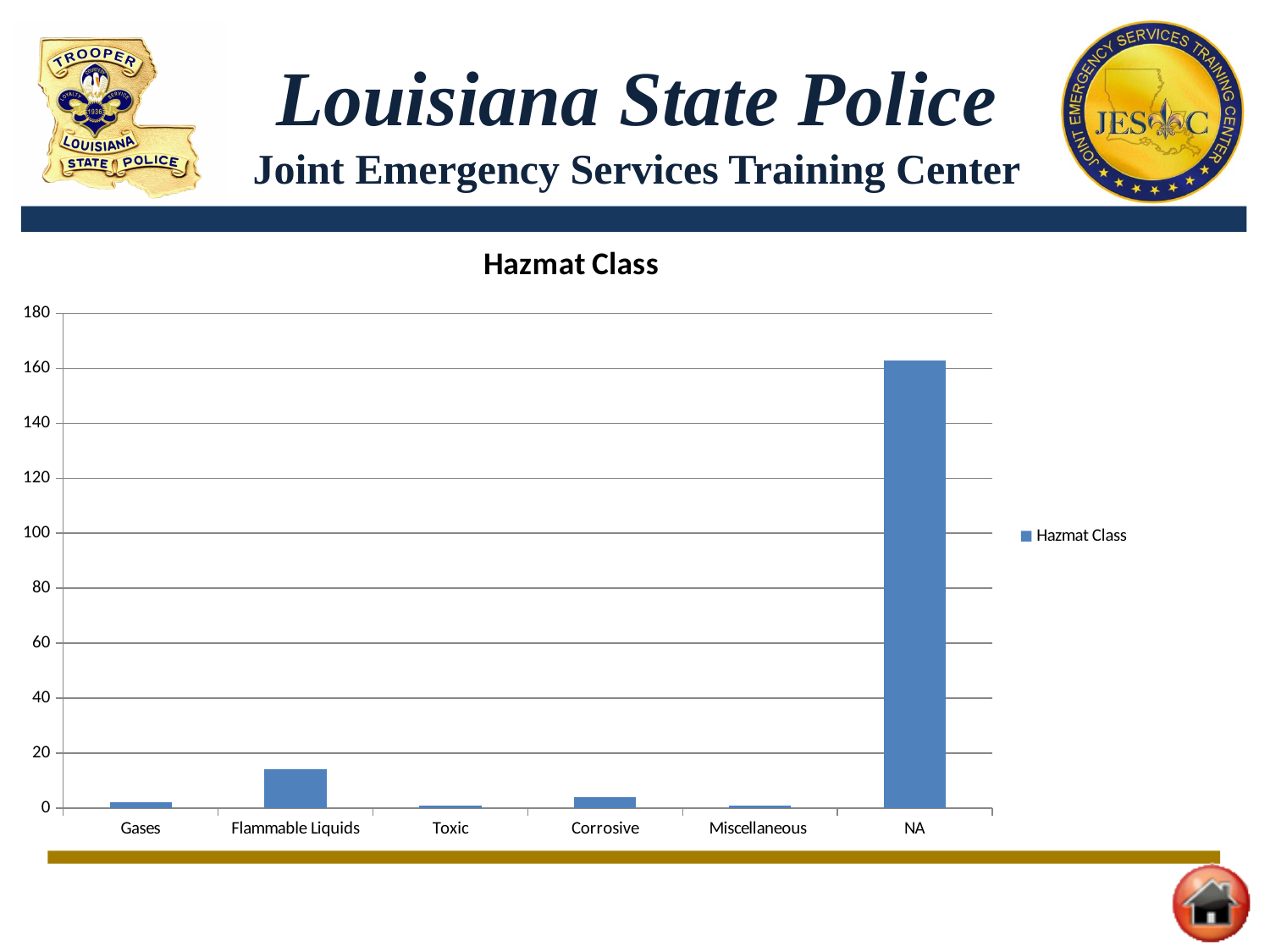
What is the title of the chart on the slide? Hazmat Class What kind of chart is shown on the slide? bar chart Which is larger in the Hazmat Class chart, the value for NA or the value for Flammable Liquids? NA Is the value for Flammable Liquids in the Hazmat Class chart greater or less than 20? less Which category has the highest value in the Hazmat Class chart? NA Which is larger in the Hazmat Class chart, the value for Flammable Liquids or the value for Corrosive? Flammable Liquids How many categories are shown on the x axis of the Hazmat Class chart? 6 Is the value for Corrosive in the Hazmat Class chart greater or less than 20? less Is the value for Gases in the Hazmat Class chart greater or less than 20? less How many series does the legend of the Hazmat Class chart list? 1 What is the name of the series listed in the chart's legend? Hazmat Class